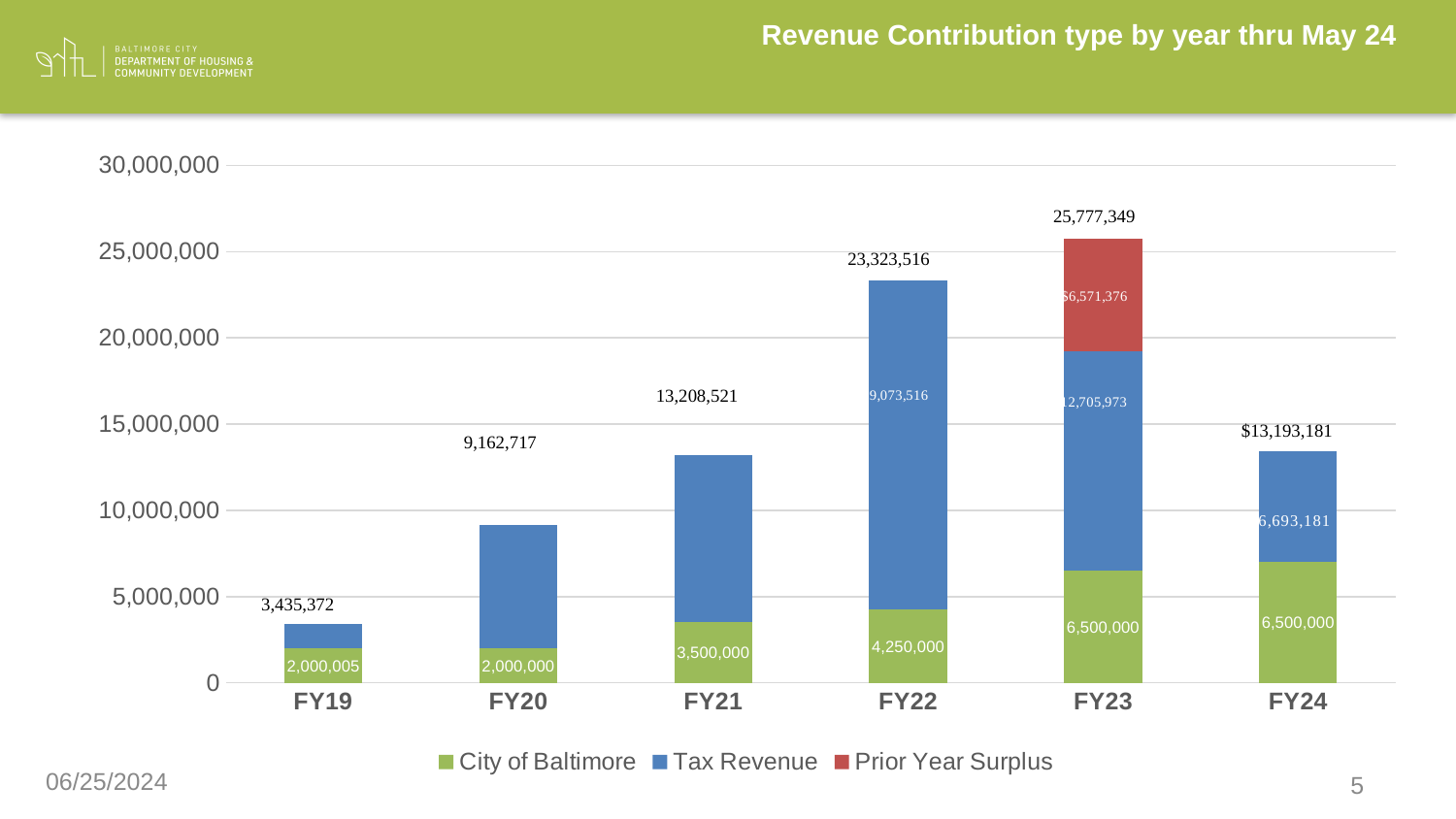
What is the City of Baltimore contribution for FY21? 3,500,000 Which is larger, the total for FY22 or the total for FY21? FY22 What is the total revenue for FY23? 25,777,349 Which fiscal year has the lowest total revenue? FY19 What is the Tax Revenue value for FY24? 6,693,181 What is the difference between the City of Baltimore contribution in FY22 and in FY21? 750,000 What kind of chart is shown on the slide? Stacked bar chart Is the Tax Revenue value for FY20 greater or less than 5,000,000? greater What is the City of Baltimore contribution for FY19? 2,000,005 How many series does the legend list? 3 How many fiscal years are shown on the x axis? 6 Which fiscal year has the highest total revenue? FY23